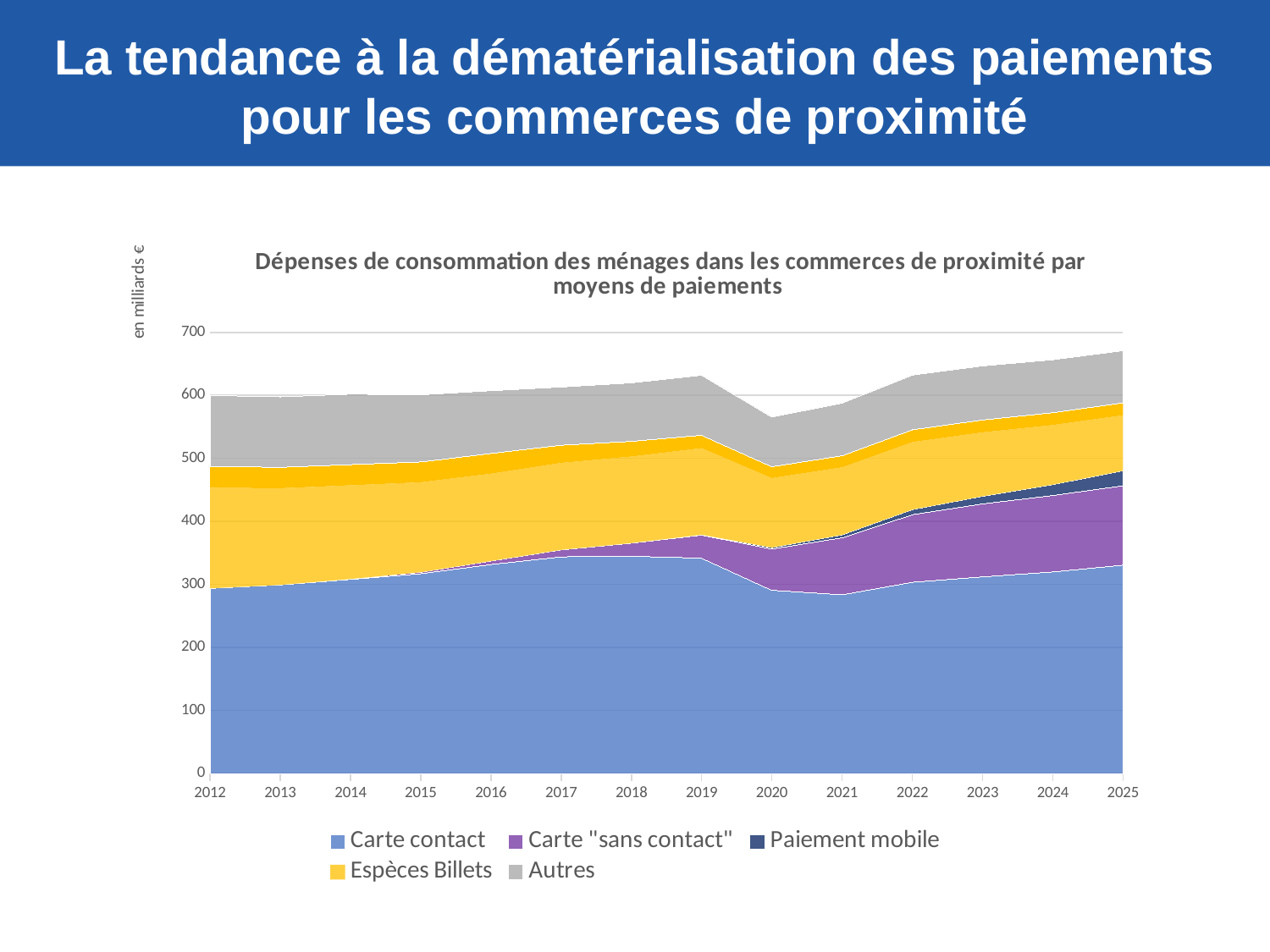
Does the value for Carte "sans contact" rise or fall from 2019 to 2025? rise Is the value for Carte contact in 2019 greater or less than 300? greater Is the total of all payment means in 2025 greater or less than 600? greater How many series does the legend list? 5 What is the first year shown on the x axis? 2012 Is the total of all payment means in 2020 greater or less than 600? less What unit is given for the y axis? en milliards € How many years are shown along the x axis? 14 What kind of chart is shown on the slide? Stacked area chart Which series is the largest in 2012? Carte contact